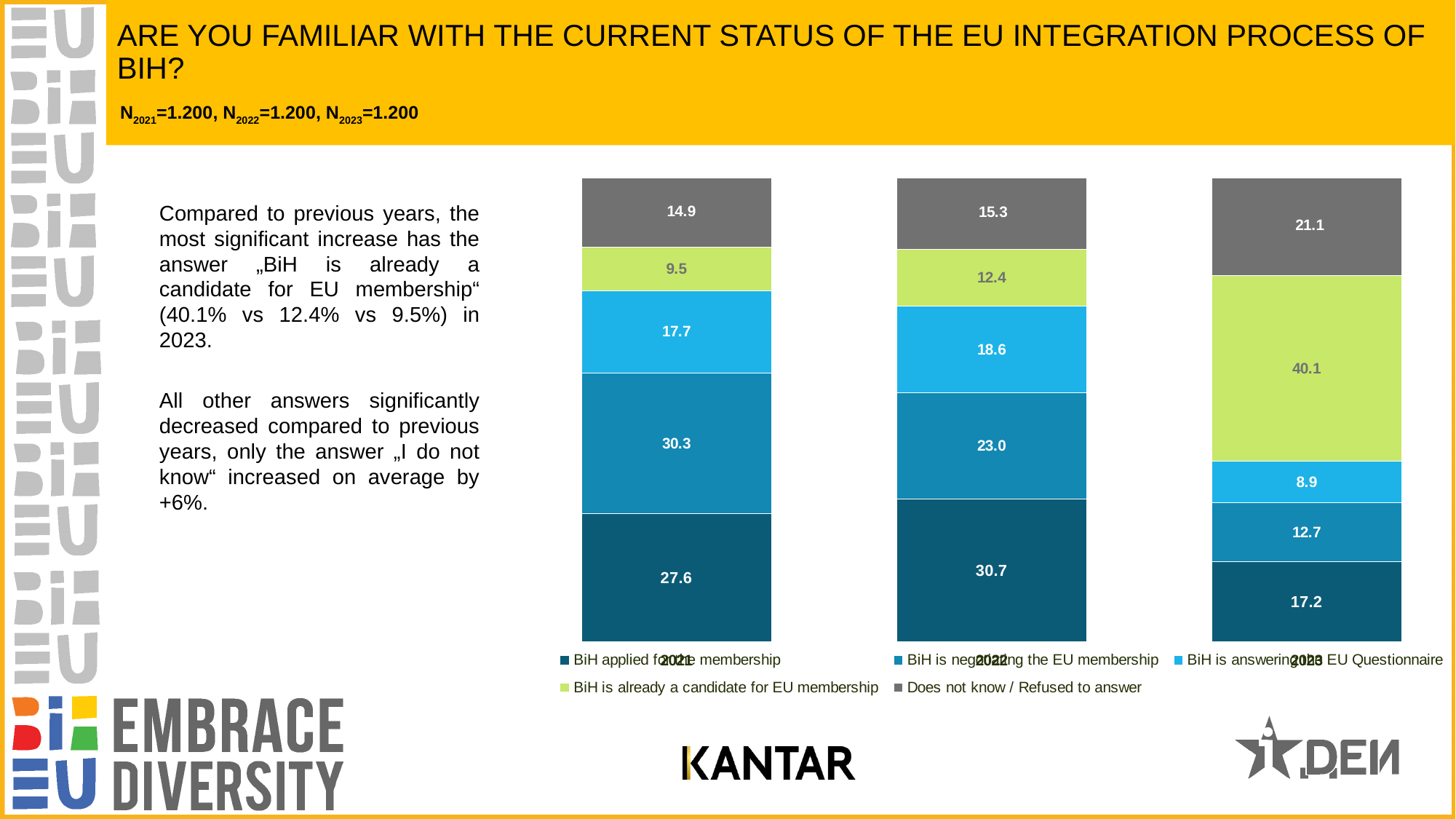
In which year is the value for "BiH applied for the EU membership" lowest? 2023 How many bars (years) are shown in the chart? 3 What is the difference between the "BiH is already a candidate for EU membership" values in 2023 and 2022? 27.7 In which year is the value for "BiH is already a candidate for EU membership" highest? 2023 How many series does the legend list? 5 What is the total of the stacked bar for 2023? 100.0 What is the value for "BiH is already a candidate for EU membership" in 2023? 40.1 What is the value for "BiH is answering the EU Questionnaire" in 2023? 8.9 Which is larger: "BiH applied for the EU membership" in 2021 or in 2022? 2022 What is the value for "Does not know / Refused to answer" in 2021? 14.9 What is the value for "BiH is negotiating the EU membership" in 2022? 23.0 What type of chart is shown on the slide? stacked bar chart